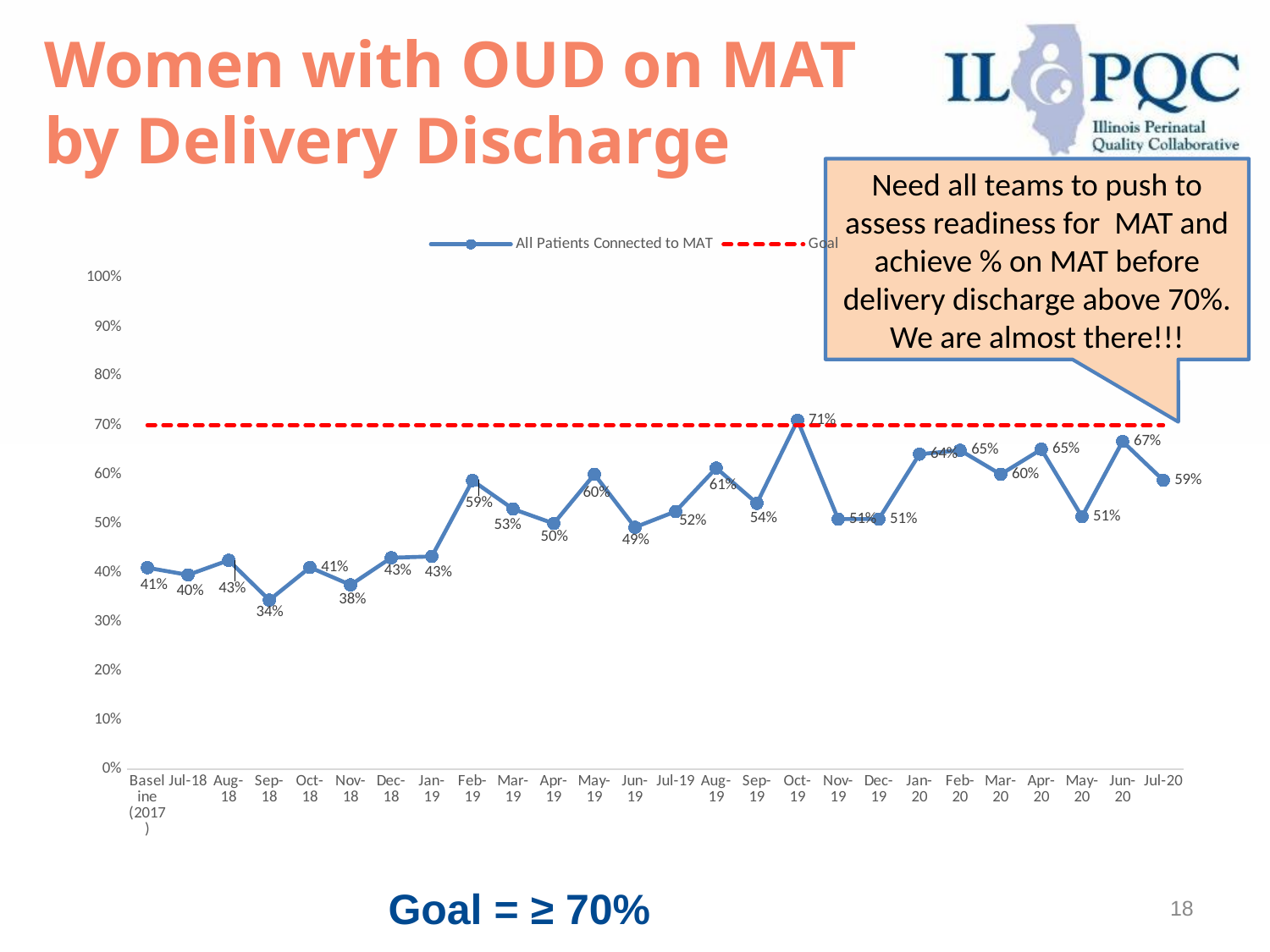
What is the value for Oct-19 on the All Patients Connected to MAT line? 71% What is the value for Jul-20, the last point on the chart? 59% Which month has the lowest percentage of patients connected to MAT? Sep-18 What is the value for the Baseline (2017) point? 41% Which is larger, the value for Feb-19 or the value for Mar-19? Feb-19 Is the value for Jan-20 greater or less than 70%? less What is the value for Sep-18? 34% Which month has the highest percentage of patients connected to MAT? Oct-19 What kind of chart is shown on the slide? Line chart How many series does the legend list? 2 What is the difference between the Jun-20 value and the Jul-20 value? 8% At what percentage is the dashed red Goal line drawn? 70%